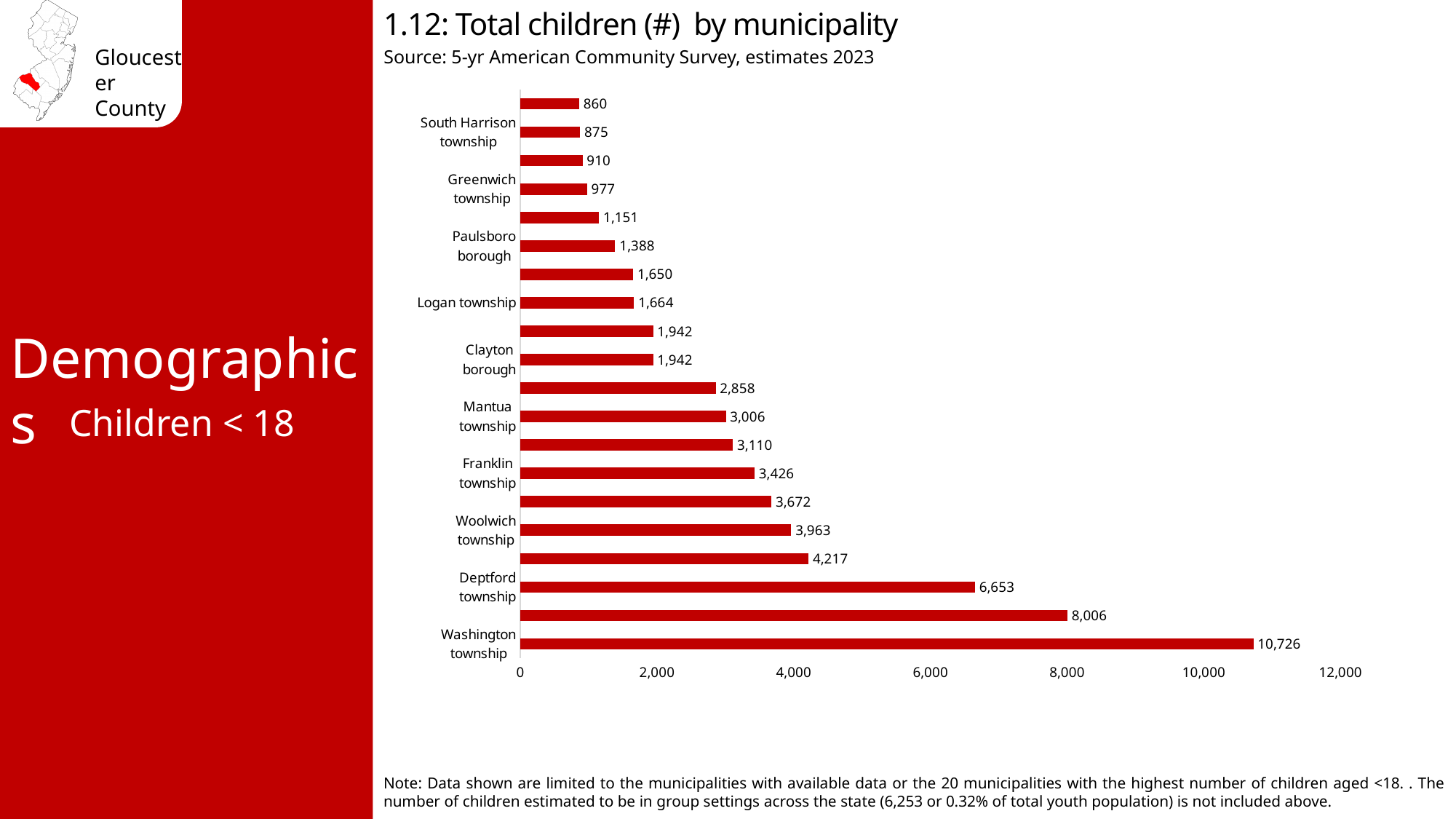
What is the value for Clayton borough? 1,942 What is the value for Deptford township? 6,653 What is the difference between Washington township and Deptford township? 4,073 What is the value for Washington township? 10,726 What is the value for Paulsboro borough? 1,388 Which municipality has the highest number of children? Washington township Which has more children, Franklin township or Mantua township? Franklin township What kind of chart is shown? bar chart How many bars are plotted on the chart? 20 What is the smallest value shown on the chart? 860 What is the value for Woolwich township? 3,963 Is the value for Logan township greater or less than 2,000? less